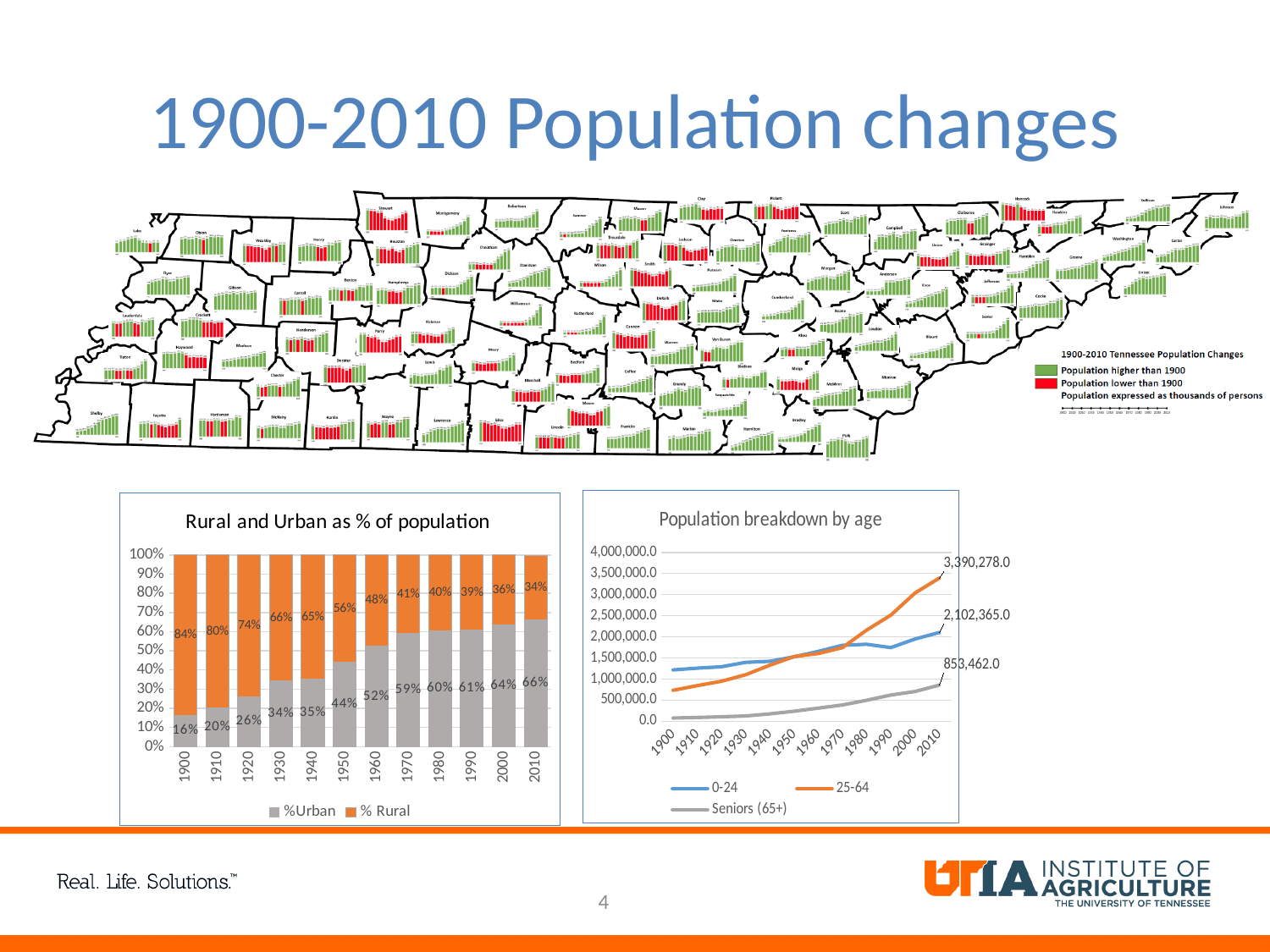
In the 'Rural and Urban as % of population' chart, does the %Urban value rise or fall from 1900 to 2010? rise In the 'Rural and Urban as % of population' chart, which year has the highest %Urban value? 2010 In the 'Rural and Urban as % of population' chart, which year has the lowest % Rural value? 2010 In the 'Population breakdown by age' chart, what is the 2010 value for the 25-64 series? 3,390,278.0 In the 'Rural and Urban as % of population' chart, how many years are shown on the x axis? 12 In the 'Population breakdown by age' chart, how many series does the legend list? 3 In the 'Rural and Urban as % of population' chart, what is the %Urban value for 1900? 16% In the 'Population breakdown by age' chart, what is the 2010 value for the Seniors (65+) series? 853,462.0 What kind of chart is 'Population breakdown by age'? line chart In the 'Rural and Urban as % of population' chart, what is the difference between the %Urban values for 2010 and 1900? 50 percentage points In the 'Rural and Urban as % of population' chart, what is the % Rural value for 1950? 56% In the 'Rural and Urban as % of population' chart, which is larger in 1960: %Urban or % Rural? %Urban